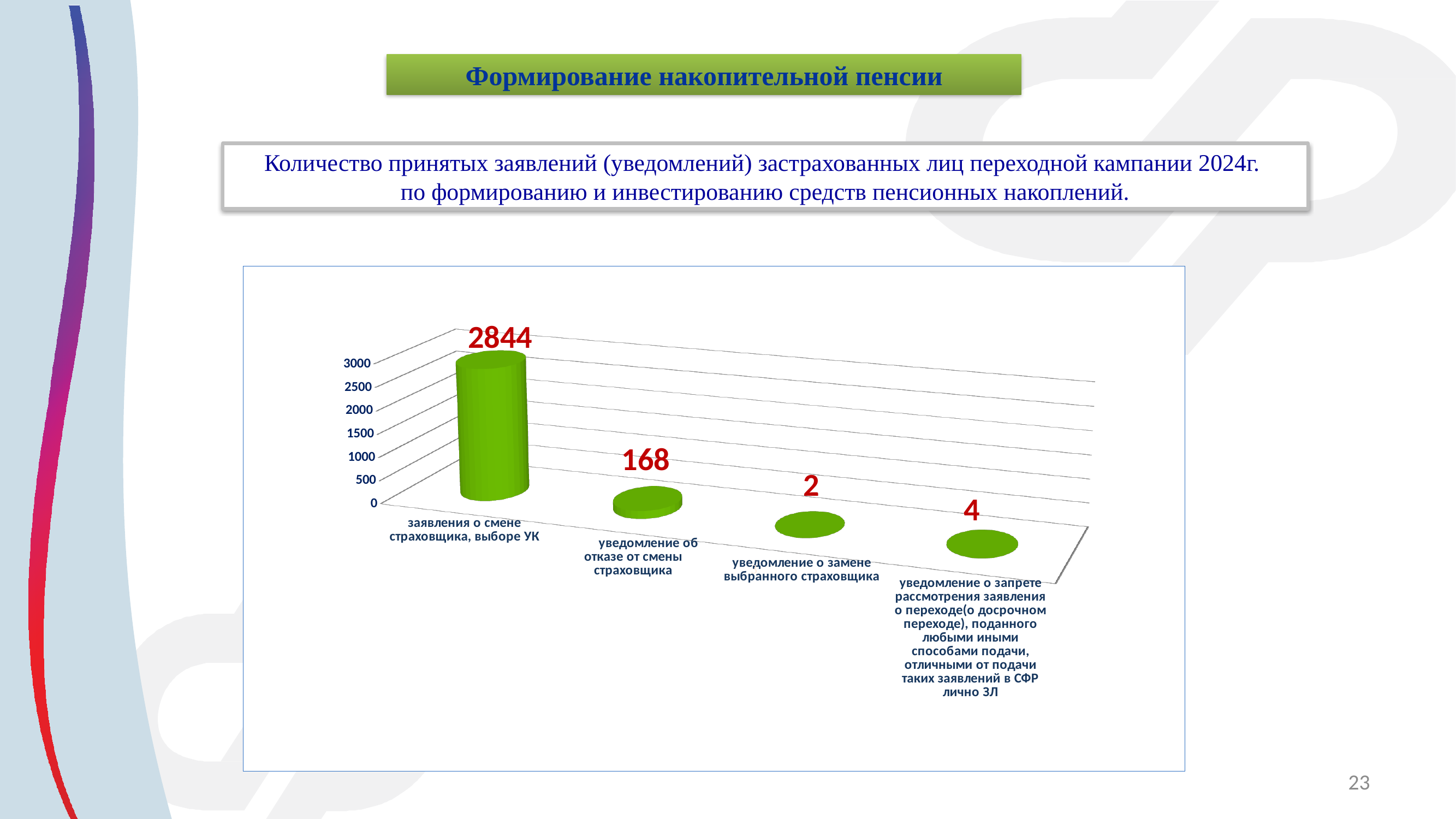
What is the difference between the values for "заявления о смене страховщика, выборе УК" and "уведомление об отказе от смены страховщика"? 2676 What is the value for "уведомление о запрете рассмотрения заявления о переходе(о досрочном переходе), поданного любыми иными способами подачи, отличными от подачи таких заявлений в СФР лично ЗЛ"? 4 What is the value for "уведомление об отказе от смены страховщика"? 168 Which is larger: the value for "уведомление о замене выбранного страховщика" or the value for "уведомление о запрете рассмотрения заявления о переходе..."? уведомление о запрете рассмотрения заявления о переходе... What is the value for "уведомление о замене выбранного страховщика"? 2 What is the value for "заявления о смене страховщика, выборе УК"? 2844 Which category has the highest value? заявления о смене страховщика, выборе УК Is the value for "заявления о смене страховщика, выборе УК" greater or less than 2500? greater How many categories are shown in the chart? 4 What kind of chart is shown on the slide? bar chart Which category has the lowest value? уведомление о замене выбранного страховщика What is the highest value shown on the vertical axis of the chart? 3000